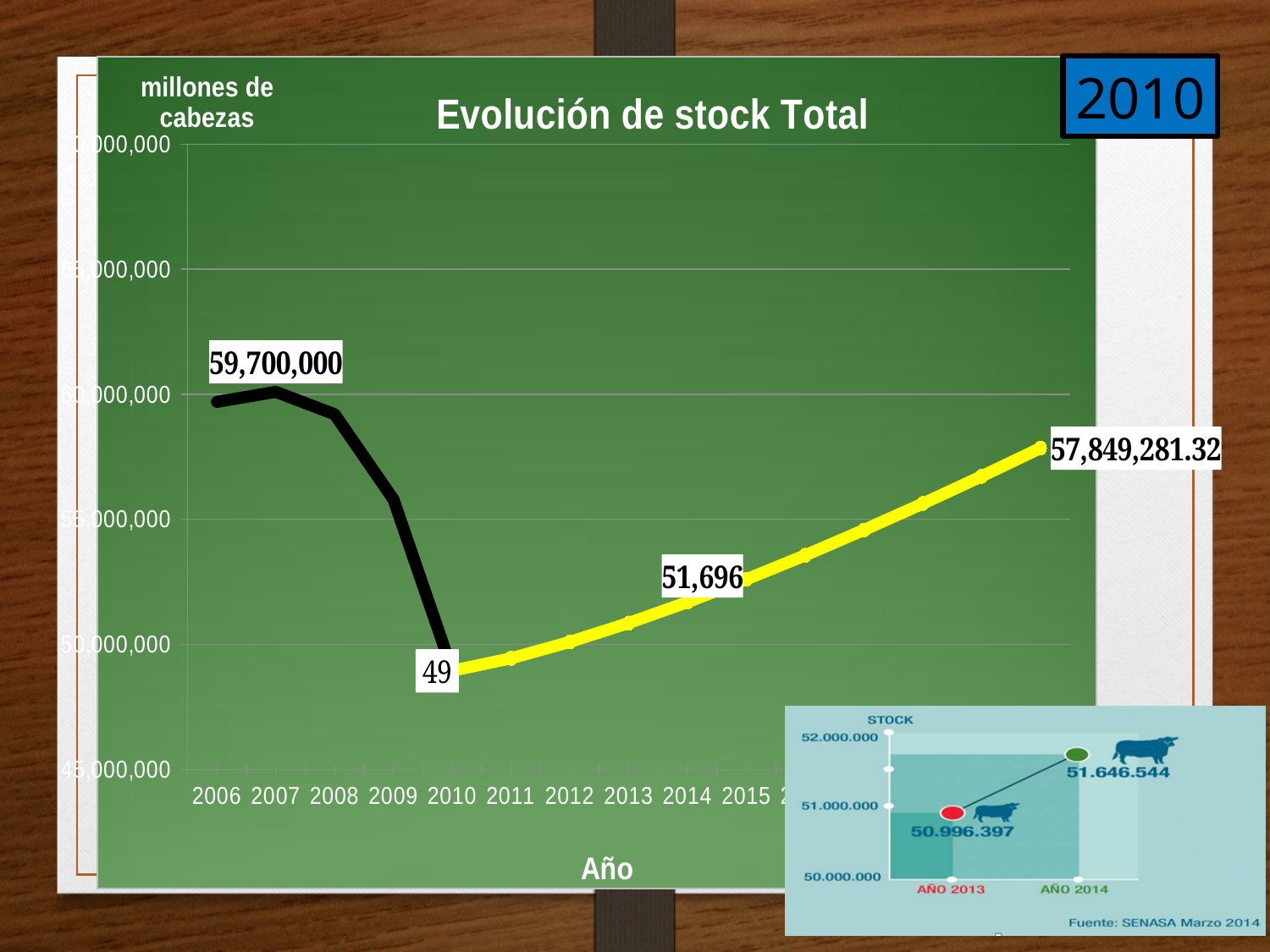
What kind of chart is 'Evolución de stock Total'? line chart In the 'Evolución de stock Total' chart, which year has the lowest stock value? 2010 In the 'Evolución de stock Total' chart, is the value for 2009 greater or less than 55,000,000? greater In the inset SENASA 'STOCK' graphic at the bottom right, what is the value shown for AÑO 2014? 51.646.544 What is the title of the main chart on the slide? Evolución de stock Total What is the label on the vertical axis of the 'Evolución de stock Total' chart? millones de cabezas In the 'Evolución de stock Total' chart, do the values rise or fall from 2010 to 2015? rise In the 'Evolución de stock Total' chart, what is the data label shown at the final point of the yellow line? 57,849,281.32 In the 'Evolución de stock Total' chart, which year has the larger value, 2007 or 2012? 2007 In the 'Evolución de stock Total' chart, what data label is shown at the 2010 point? 49 In the 'Evolución de stock Total' chart, is the value for 2007 greater or less than 55,000,000? greater